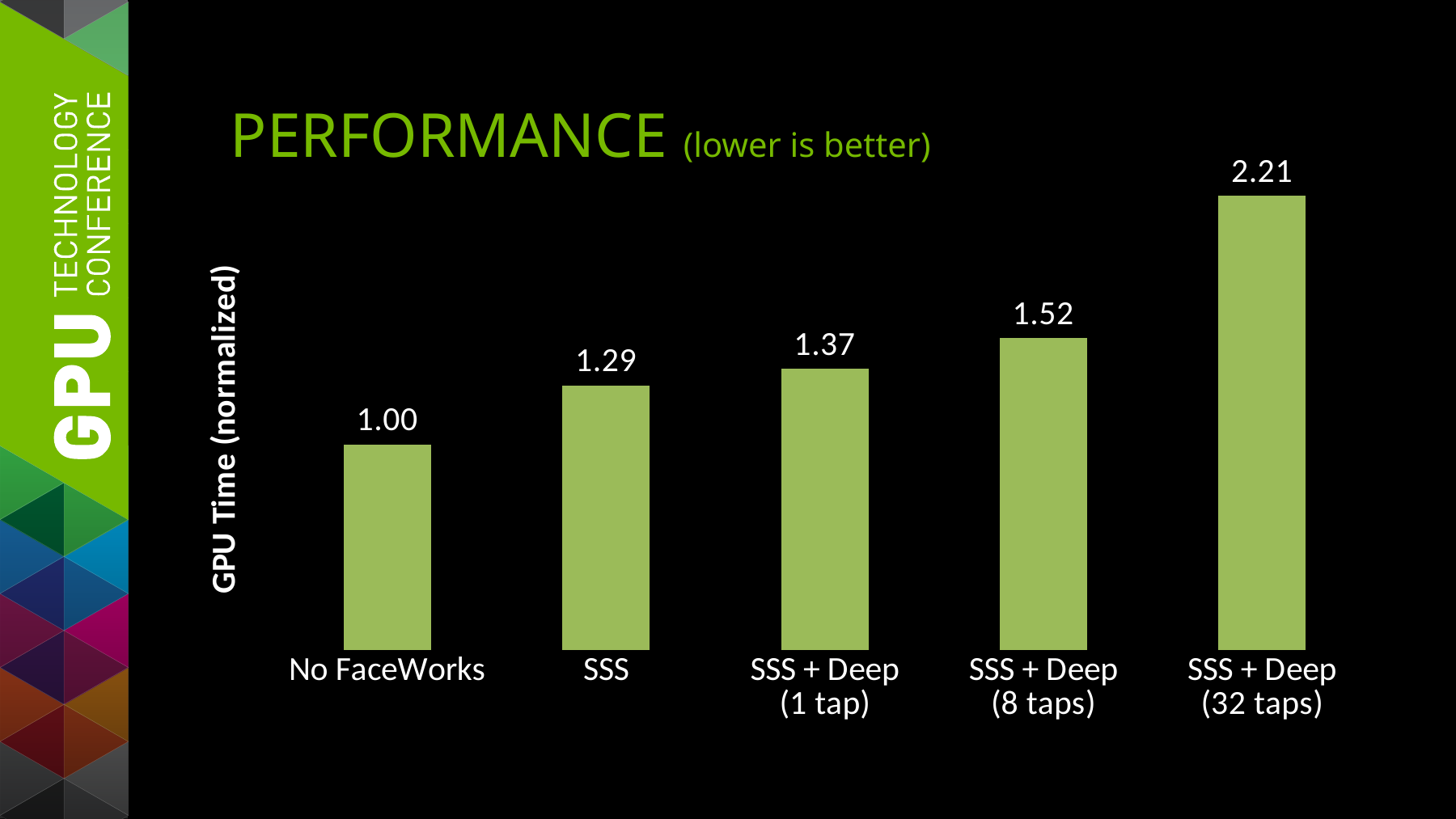
What is the normalized GPU time for SSS + Deep (8 taps)? 1.52 Which category has the highest normalized GPU time? SSS + Deep (32 taps) What is the normalized GPU time for SSS + Deep (32 taps)? 2.21 Do the values rise or fall from left to right across the categories? Rise What is the difference in normalized GPU time between SSS + Deep (8 taps) and SSS + Deep (1 tap)? 0.15 What is the normalized GPU time for No FaceWorks? 1.00 What is the normalized GPU time for SSS? 1.29 Which has a higher normalized GPU time, SSS or SSS + Deep (1 tap)? SSS + Deep (1 tap) How many categories are shown in the chart? 5 What is the difference in normalized GPU time between SSS + Deep (32 taps) and No FaceWorks? 1.21 What kind of chart is shown on the slide? Bar chart Which category has the lowest normalized GPU time? No FaceWorks